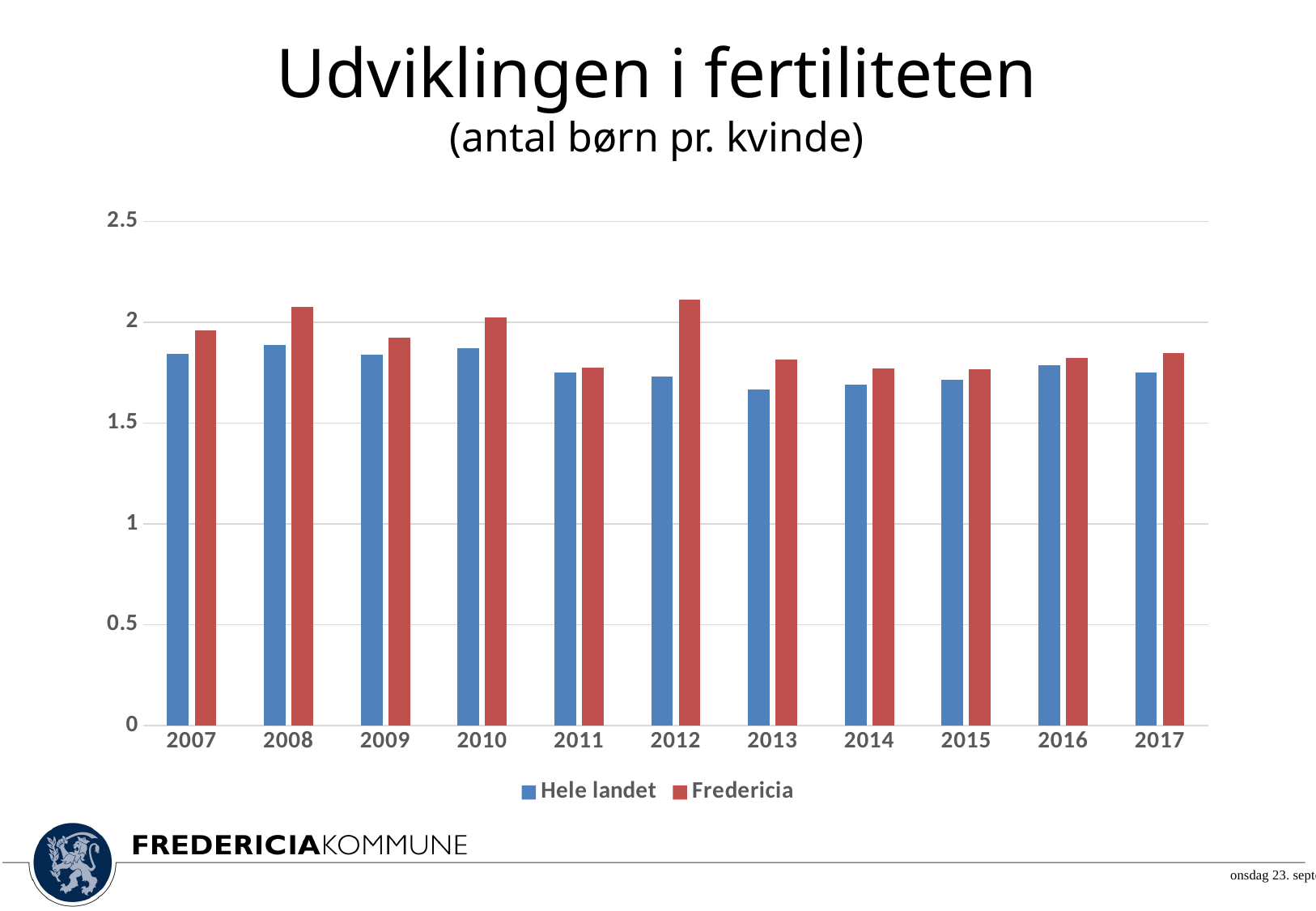
Is the Fredericia value for 2008 greater or less than 2? greater Does the Fredericia value rise or fall from 2012 to 2013? fall In which year is the Fredericia value highest? 2012 Is the Fredericia value for 2012 greater or less than 2? greater Is the Hele landet value for 2007 greater or less than 1.5? greater How many years are shown on the x axis? 11 How many series does the legend list? 2 Which colour represents Fredericia in the chart? red What kind of chart is shown on the slide? bar chart In 2012, which is larger: Hele landet or Fredericia? Fredericia In 2007, which is larger: Hele landet or Fredericia? Fredericia